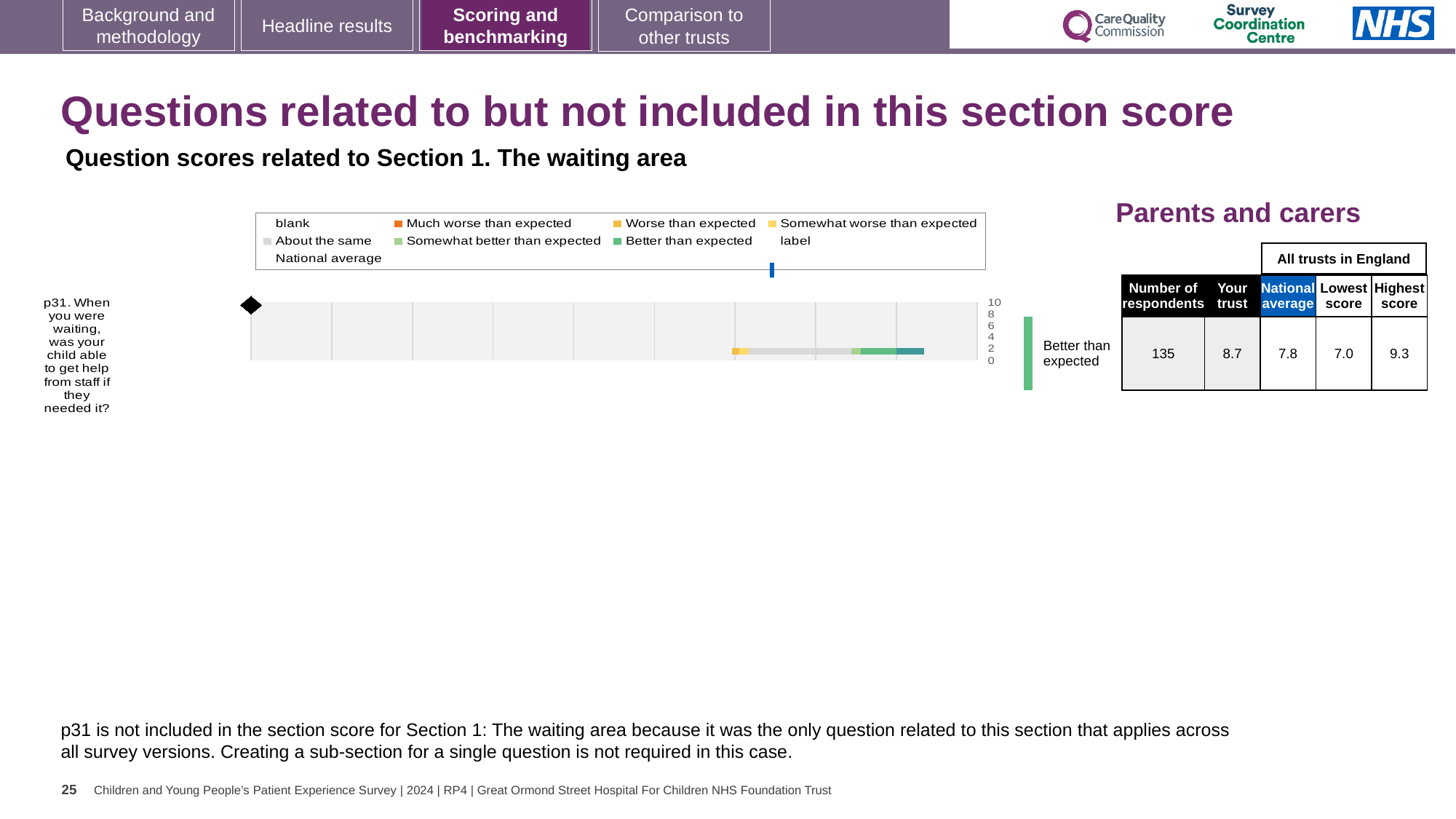
Which question is plotted in the chart? p31. When you were waiting, was your child able to get help from staff if they needed it? What is the difference between the 'Your trust' score and the national average for p31? 0.9 What kind of chart is shown on the slide for question p31? Bar chart How many respondents answered p31? 135 What is the 'Your trust' score for p31 in the table? 8.7 What colour does the legend use for 'Much worse than expected'? Orange What is the national average score for p31 in the table? 7.8 How many questions (categories) are plotted in the chart? 1 Which is larger for p31, the 'Your trust' score or the national average? Your trust What rating label is shown to the right of the chart for p31? Better than expected What is the lowest score among all trusts in England for p31? 7.0 What is the highest score among all trusts in England for p31? 9.3